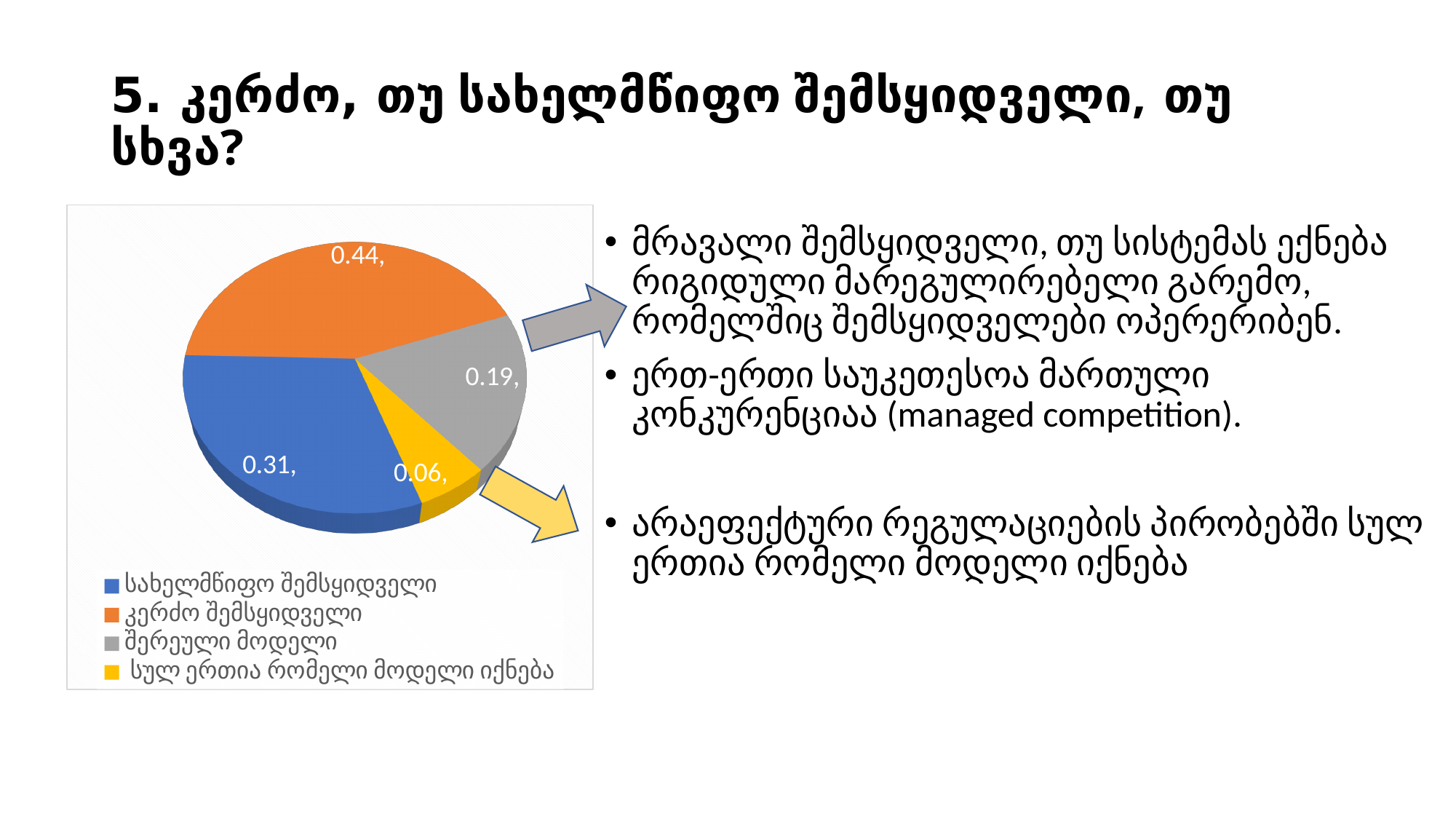
How many slices does the pie chart have? 4 What type of chart is shown on the slide? Pie chart Which is larger in the pie chart: შერეული მოდელი or სულ ერთია რომელი მოდელი იქნება? შერეული მოდელი What colour is the კერძო შემსყიდველი slice in the pie chart? Orange What value is shown for the სახელმწიფო შემსყიდველი slice of the pie chart? 0.31 What value is shown for the სულ ერთია რომელი მოდელი იქნება slice of the pie chart? 0.06 Which category has the largest slice in the pie chart? კერძო შემსყიდველი Which category has the smallest slice in the pie chart? სულ ერთია რომელი მოდელი იქნება What value is shown for the კერძო შემსყიდველი slice of the pie chart? 0.44 What is the difference between the კერძო შემსყიდველი value and the სახელმწიფო შემსყიდველი value in the pie chart? 0.13 How many entries does the legend of the pie chart list? 4 What value is shown for the შერეული მოდელი slice of the pie chart? 0.19